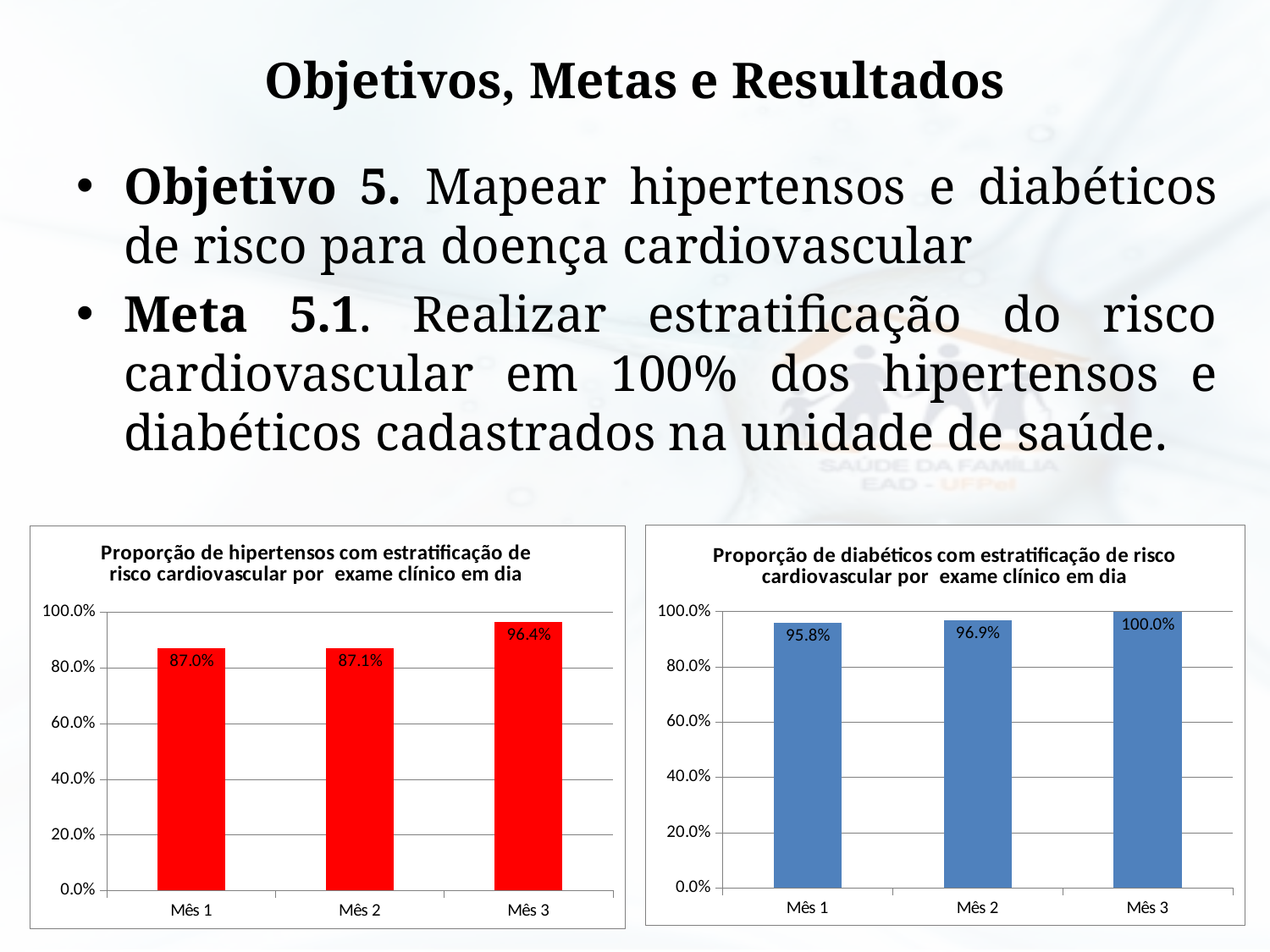
What kind of chart is the left chart (Proporção de hipertensos)? Bar chart In the left chart (Proporção de hipertensos com estratificação de risco cardiovascular por exame clínico em dia), what is the value for Mês 3? 96.4% In the left chart (Proporção de hipertensos com estratificação de risco cardiovascular por exame clínico em dia), what is the value for Mês 1? 87.0% How many months (categories) are shown in the right chart (Proporção de diabéticos)? 3 In the right chart (Proporção de diabéticos com estratificação de risco cardiovascular por exame clínico em dia), what is the value for Mês 2? 96.9% In the left chart (Proporção de hipertensos), which month has the highest value? Mês 3 In the right chart (Proporção de diabéticos com estratificação de risco cardiovascular por exame clínico em dia), what is the value for Mês 3? 100.0% In the left chart (Proporção de hipertensos), is the value for Mês 2 greater or less than 80.0%? greater In the left chart (Proporção de hipertensos), what is the difference between the values for Mês 3 and Mês 1? 9.4% In the right chart (Proporção de diabéticos), what is the difference between the values for Mês 3 and Mês 1? 4.2% In the right chart (Proporção de diabéticos), do the values rise or fall from Mês 1 to Mês 3? Rise In the right chart (Proporção de diabéticos), which month has the lowest value? Mês 1